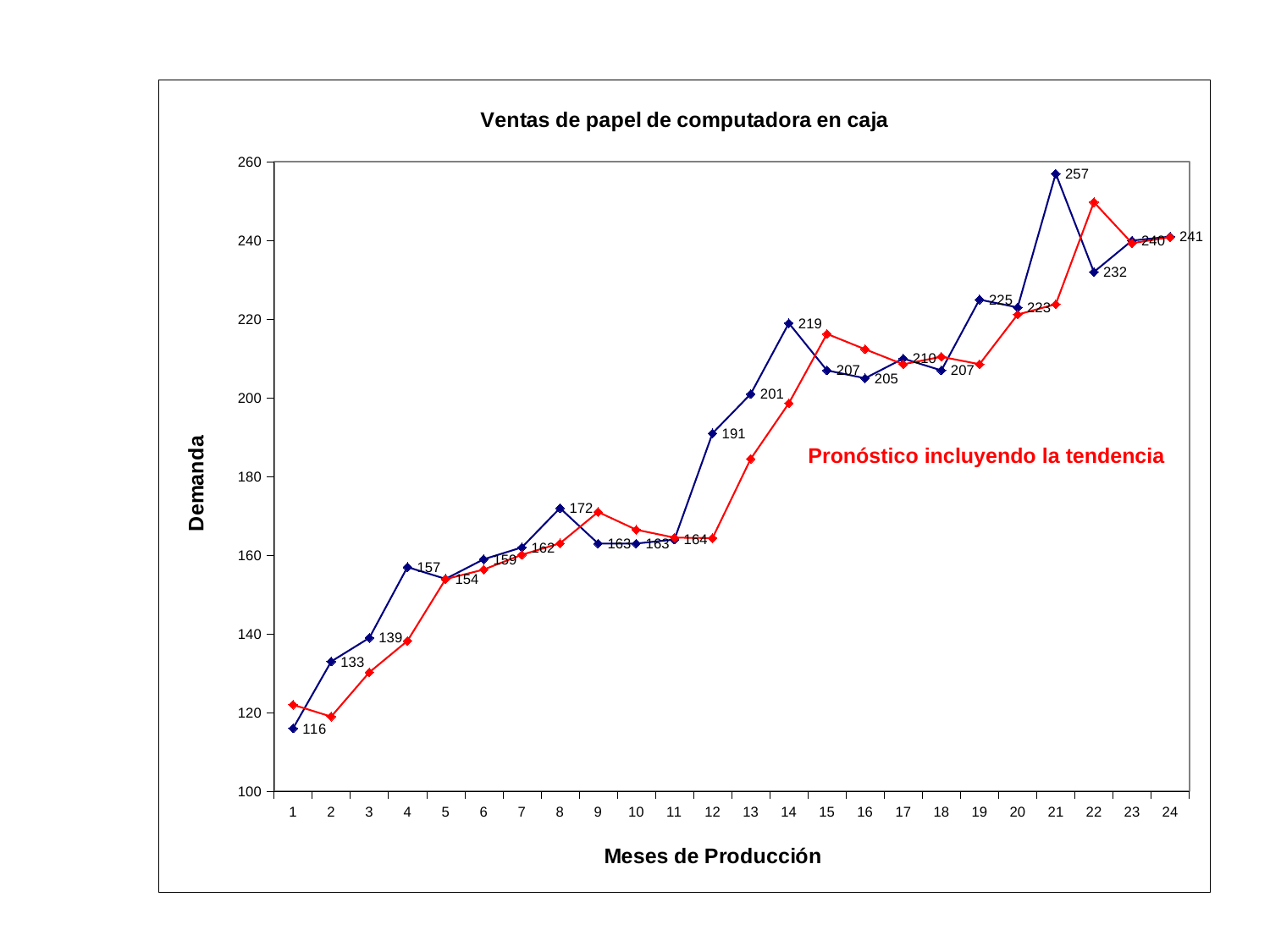
What is the labelled demand value for month 24 on the blue line? 241 What does the red text on the chart say the red line represents? Pronóstico incluyendo la tendencia What is the difference between the blue line's values for month 21 and month 22? 25 How many months are plotted along the x axis? 24 Which month has the larger value on the blue line, month 9 or month 12? 12 In which month does the blue line have its lowest labelled value? 1 What type of chart is shown on the slide? line chart What is the labelled demand value for month 14 on the blue line? 219 What is the labelled demand value for month 1 on the blue line? 116 Is the value of the red forecast line at month 22 greater or less than 240? greater What is the title of the chart? Ventas de papel de computadora en caja In which month does the blue line reach its highest labelled value? 21